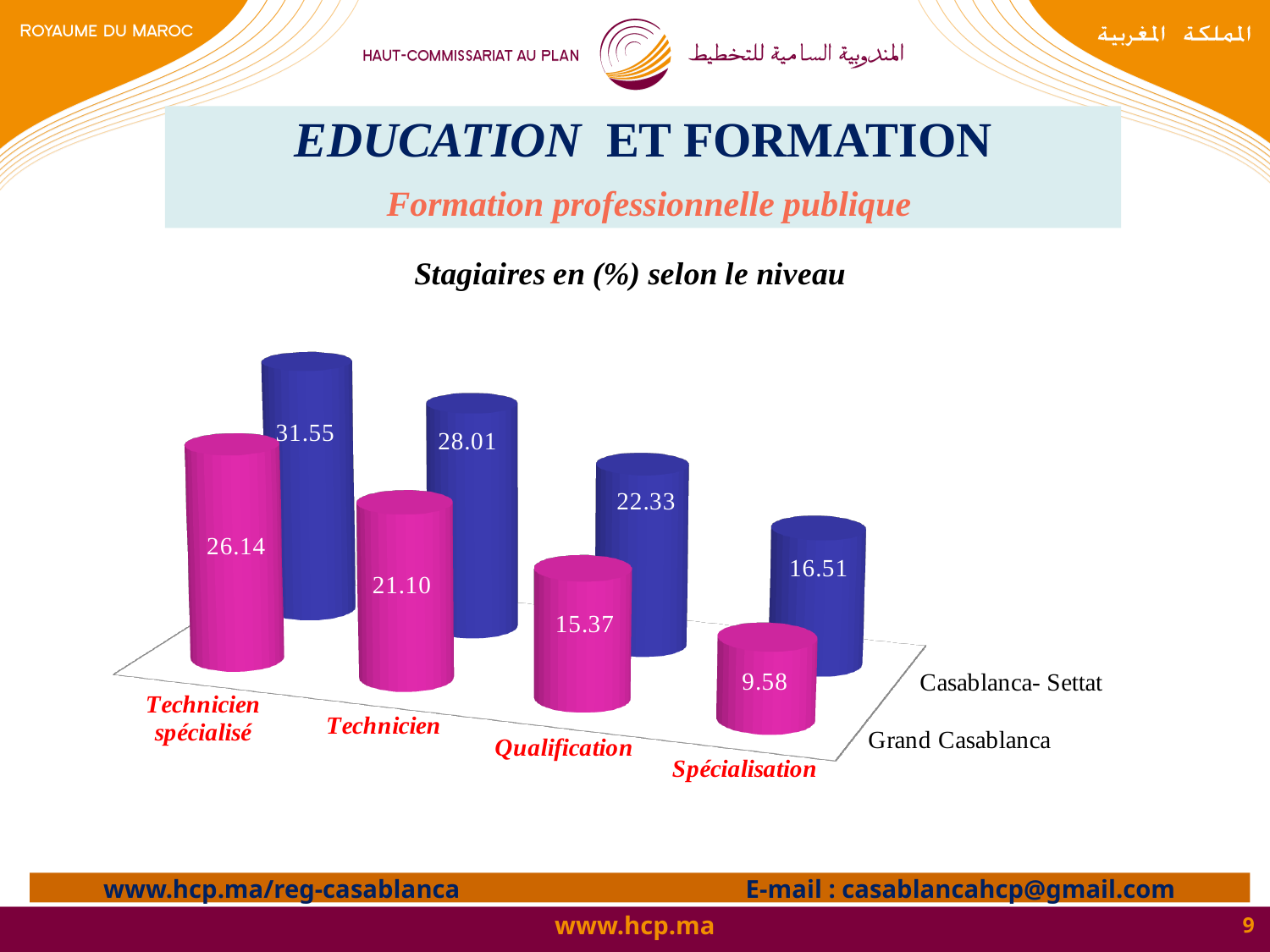
What is the value for Technicien in the Casablanca- Settat series? 28.01 How many levels (categories) are shown on the chart? 4 What is the difference between the Casablanca- Settat and Grand Casablanca values for Technicien? 6.91 How many series does the chart show? 2 What kind of chart is shown on the slide? Bar chart Which level has the highest value in the Casablanca- Settat series? Technicien spécialisé Which is larger for Spécialisation: the Grand Casablanca value or the Casablanca- Settat value? Casablanca- Settat Do the Grand Casablanca values rise or fall from Technicien spécialisé to Spécialisation? Fall What is the value for Spécialisation in the Grand Casablanca series? 9.58 Which level has the lowest value in the Grand Casablanca series? Spécialisation What is the value for Qualification in the Casablanca- Settat series? 22.33 What is the value for Technicien spécialisé in the Grand Casablanca series? 26.14